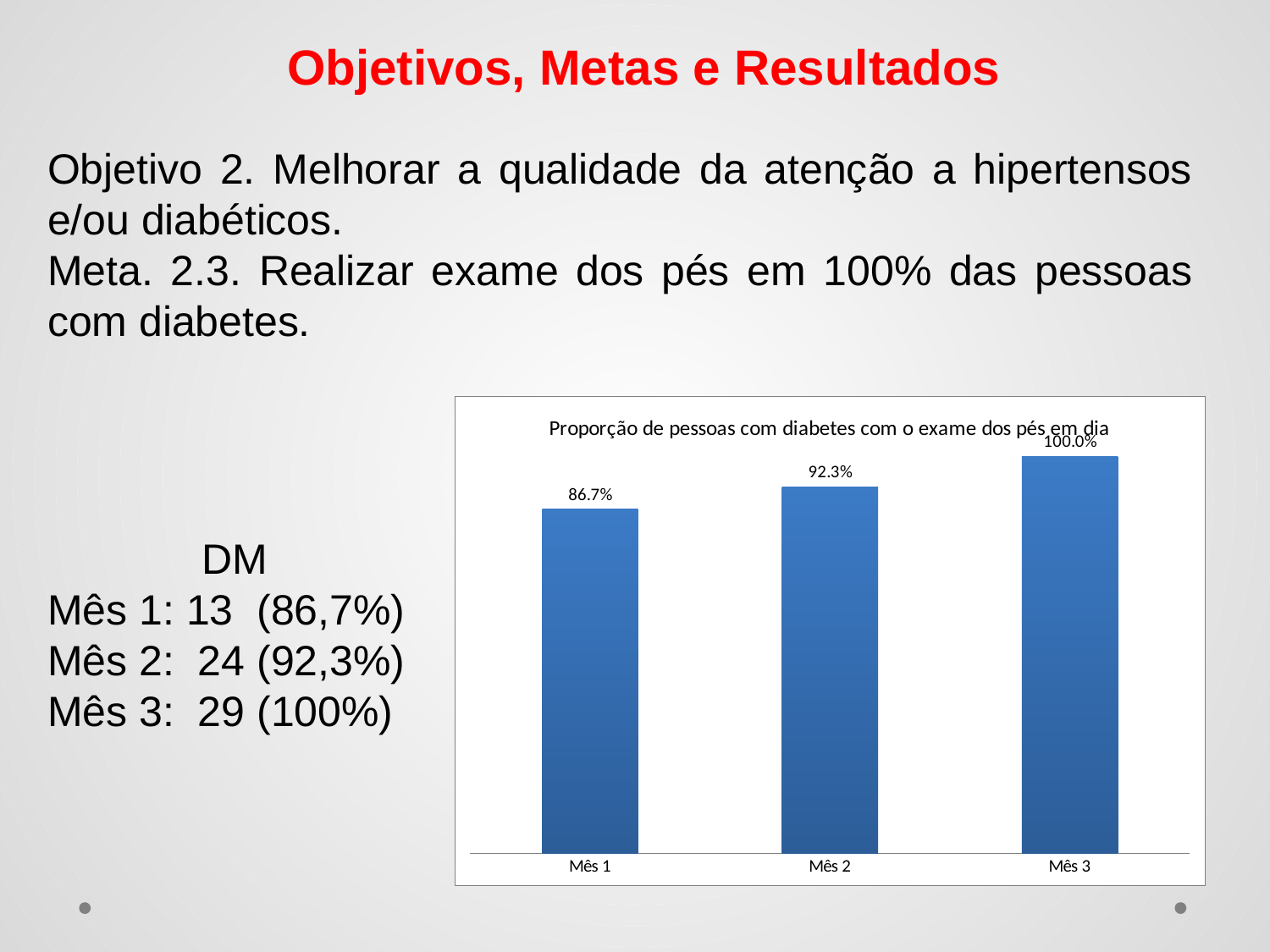
What kind of chart is shown? Bar chart Do the values rise or fall from Mês 1 to Mês 3? Rise How many months are shown on the x axis? 3 What is the difference between the values for Mês 2 and Mês 1? 5.6% Which month has the highest value? Mês 3 What is the title of the chart? Proporção de pessoas com diabetes com o exame dos pés em dia What is the value for Mês 2? 92.3% Which is larger, the value for Mês 1 or the value for Mês 2? Mês 2 What is the value for Mês 3? 100.0% Which month has the lowest value? Mês 1 What is the difference between the values for Mês 3 and Mês 1? 13.3% What is the value for Mês 1? 86.7%